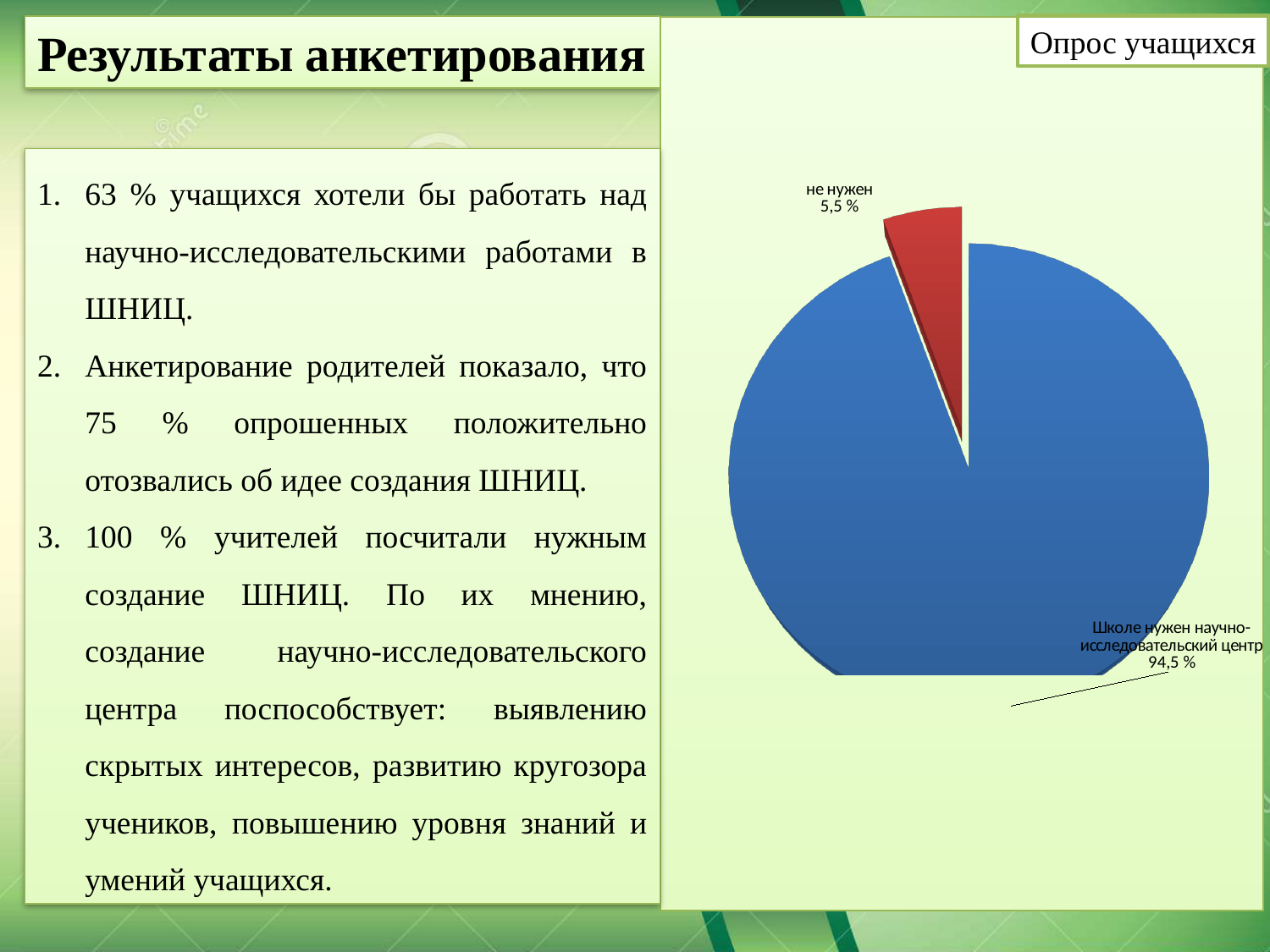
What is the difference between the "Школе нужен научно-исследовательский центр" slice and the "не нужен" slice? 89 % Which slice of the pie chart is the smallest? не нужен What colour is the "не нужен" slice of the pie chart? red What share of the pie does the "не нужен" slice represent? 5,5 % Which is larger: the "не нужен" slice or the "Школе нужен научно-исследовательский центр" slice? Школе нужен научно-исследовательский центр How many slices does the pie chart have? 2 What is the title shown above the pie chart? Опрос учащихся What is the value of the slice labelled "не нужен"? 5,5 % What is the value of the slice labelled "Школе нужен научно-исследовательский центр"? 94,5 % What kind of chart is shown on the slide? pie chart Which slice of the pie chart is the largest? Школе нужен научно-исследовательский центр